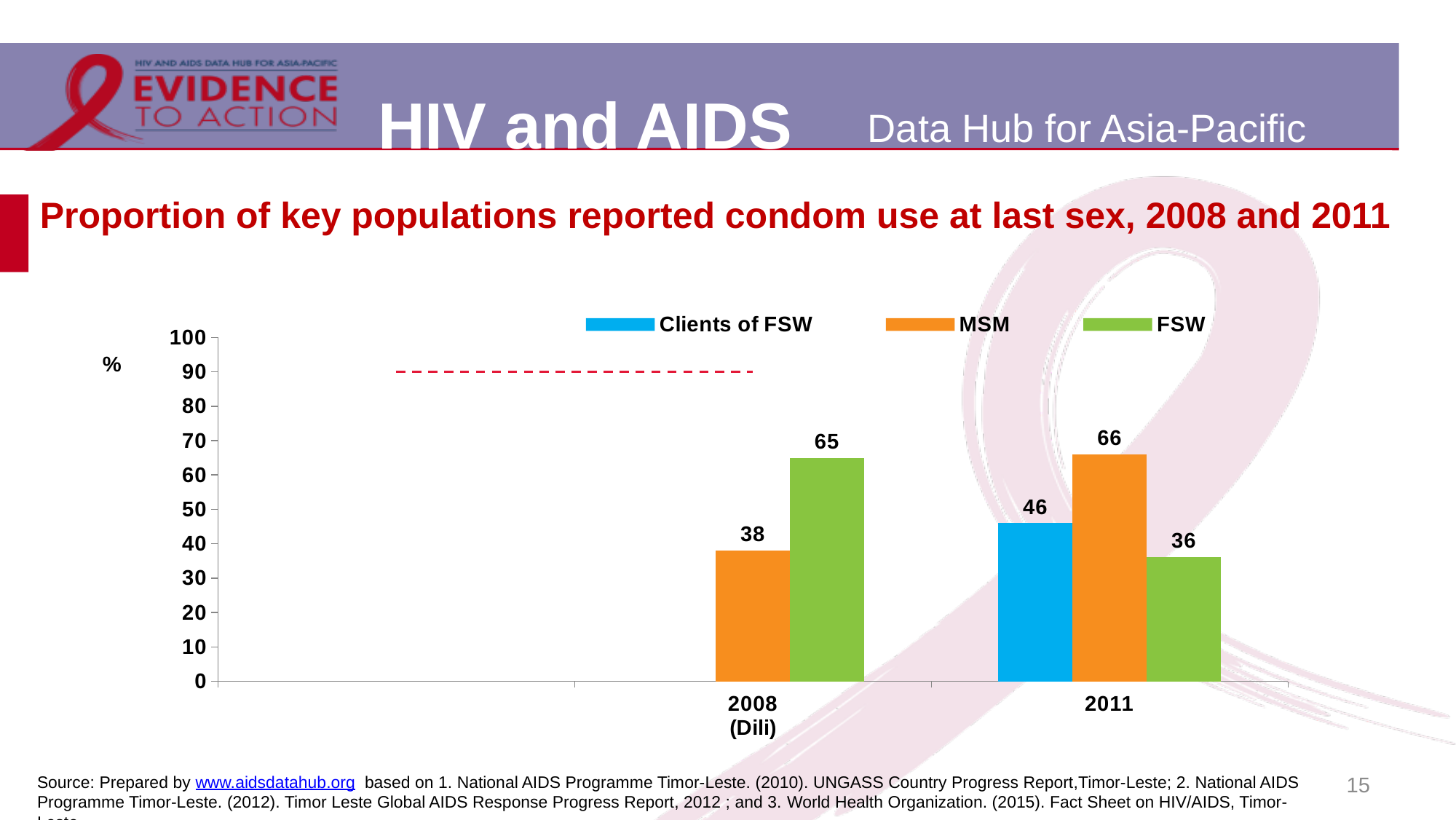
What kind of chart is shown on the slide? Bar chart Did the MSM value rise or fall from 2008 (Dili) to 2011? Rise What is the value for Clients of FSW in 2011? 46 How many year categories are shown on the x axis? 2 Which is larger, the MSM value in 2008 (Dili) or the FSW value in 2008 (Dili)? FSW in 2008 (Dili) What is the value for FSW in 2011? 36 Which series has the highest value in 2011? MSM Which series has the lowest value in 2011? FSW What is the difference between the FSW values in 2008 (Dili) and 2011? 29 What is the value for MSM in 2011? 66 What is the value for MSM in 2008 (Dili)? 38 How many series does the legend list? 3